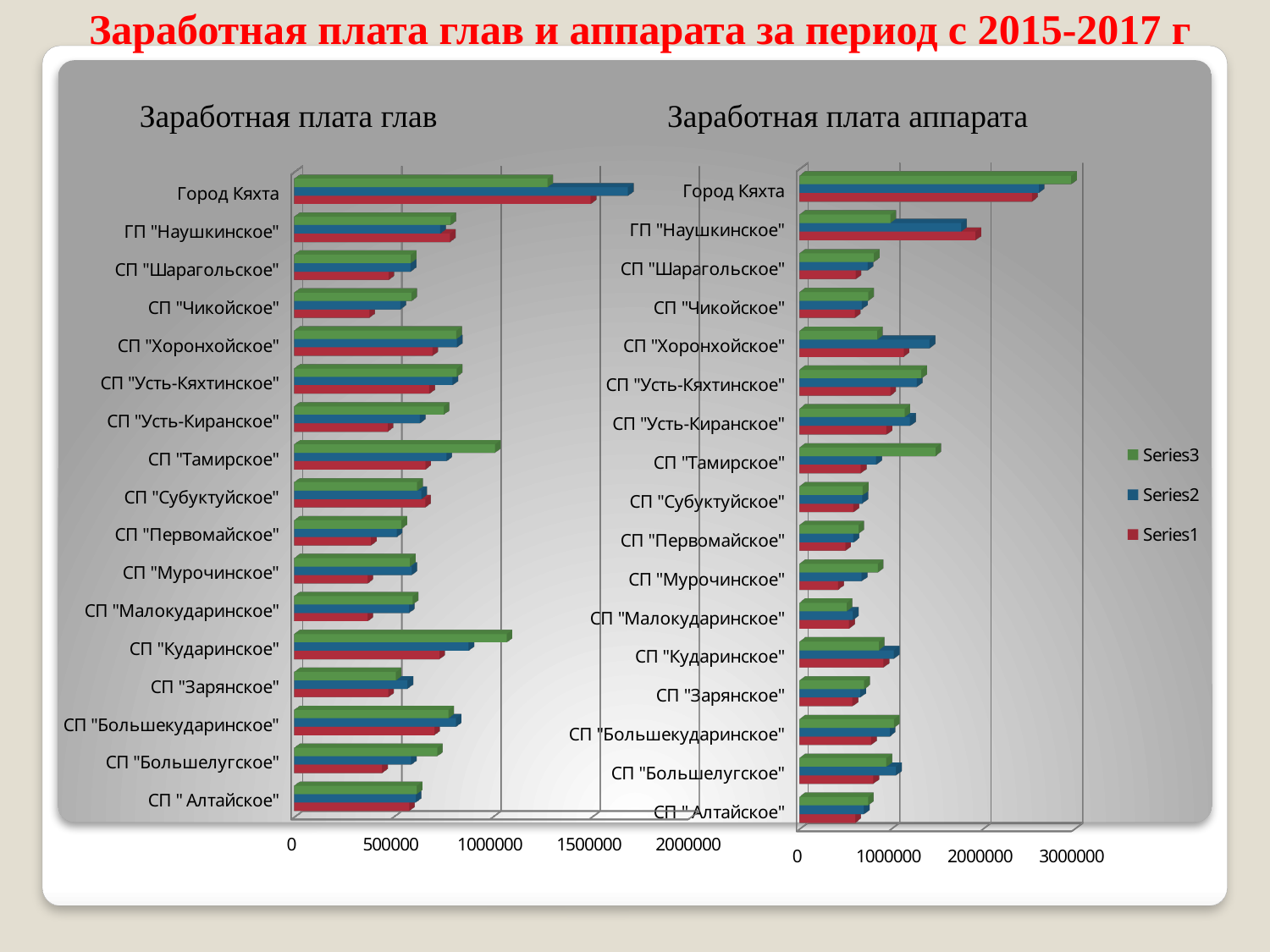
In the "Заработная плата аппарата" chart, is the Series3 value for СП "Тамирское" greater or less than 1000000? greater In the "Заработная плата глав" chart, is the Series1 value for СП "Чикойское" greater or less than 500000? less In the "Заработная плата аппарата" chart, is the Series1 value for Город Кяхта greater or less than 2000000? greater How many categories are shown in the "Заработная плата аппарата" chart? 17 What kind of chart is "Заработная плата глав"? bar chart In the "Заработная плата глав" chart, which has the larger Series2 value: Город Кяхта or ГП "Наушкинское"? Город Кяхта How many series does the legend list? 3 In the "Заработная плата глав" chart, which category has the highest value? Город Кяхта What are the entries listed in the legend? Series3, Series2, Series1 In the "Заработная плата аппарата" chart, which category has the highest value? Город Кяхта